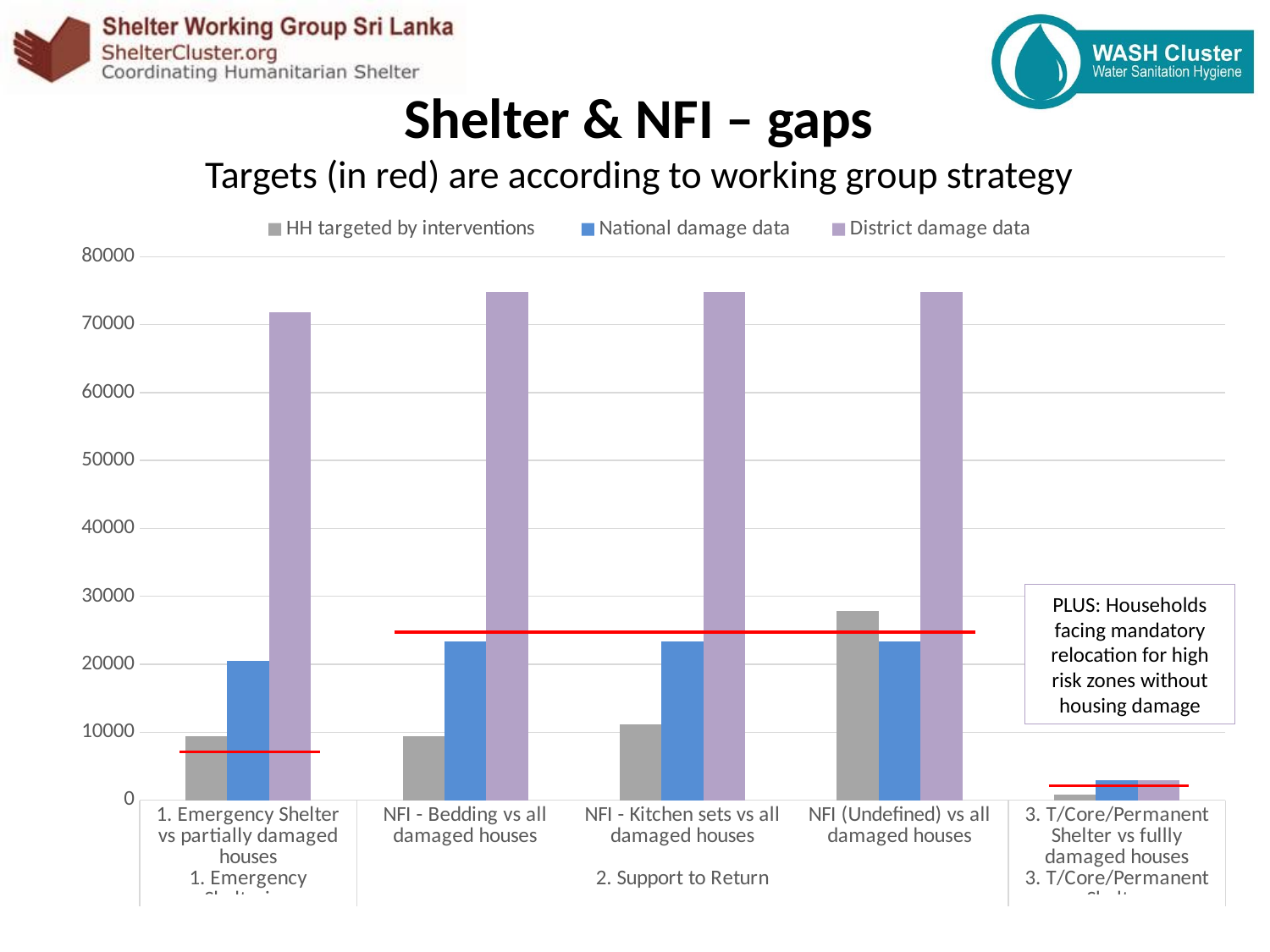
Is the District damage data value for '1. Emergency Shelter vs partially damaged houses' greater or less than 60000? greater Is the National damage data value for 'NFI - Bedding vs all damaged houses' greater or less than 20000? greater Which category has the highest value for HH targeted by interventions? NFI (Undefined) vs all damaged houses How many series does the chart legend list? 3 According to the slide subtitle, what do the red lines on the chart represent? Targets according to working group strategy Which category has the lowest value for District damage data? 3. T/Core/Permanent Shelter vs fullly damaged houses Is the HH targeted by interventions value for '1. Emergency Shelter vs partially damaged houses' greater or less than 20000? less For 'NFI (Undefined) vs all damaged houses', which is larger: HH targeted by interventions or National damage data? HH targeted by interventions What kind of chart is shown on the slide? bar chart For '1. Emergency Shelter vs partially damaged houses', which is larger: National damage data or District damage data? District damage data How many categories are shown along the x axis of the chart? 5